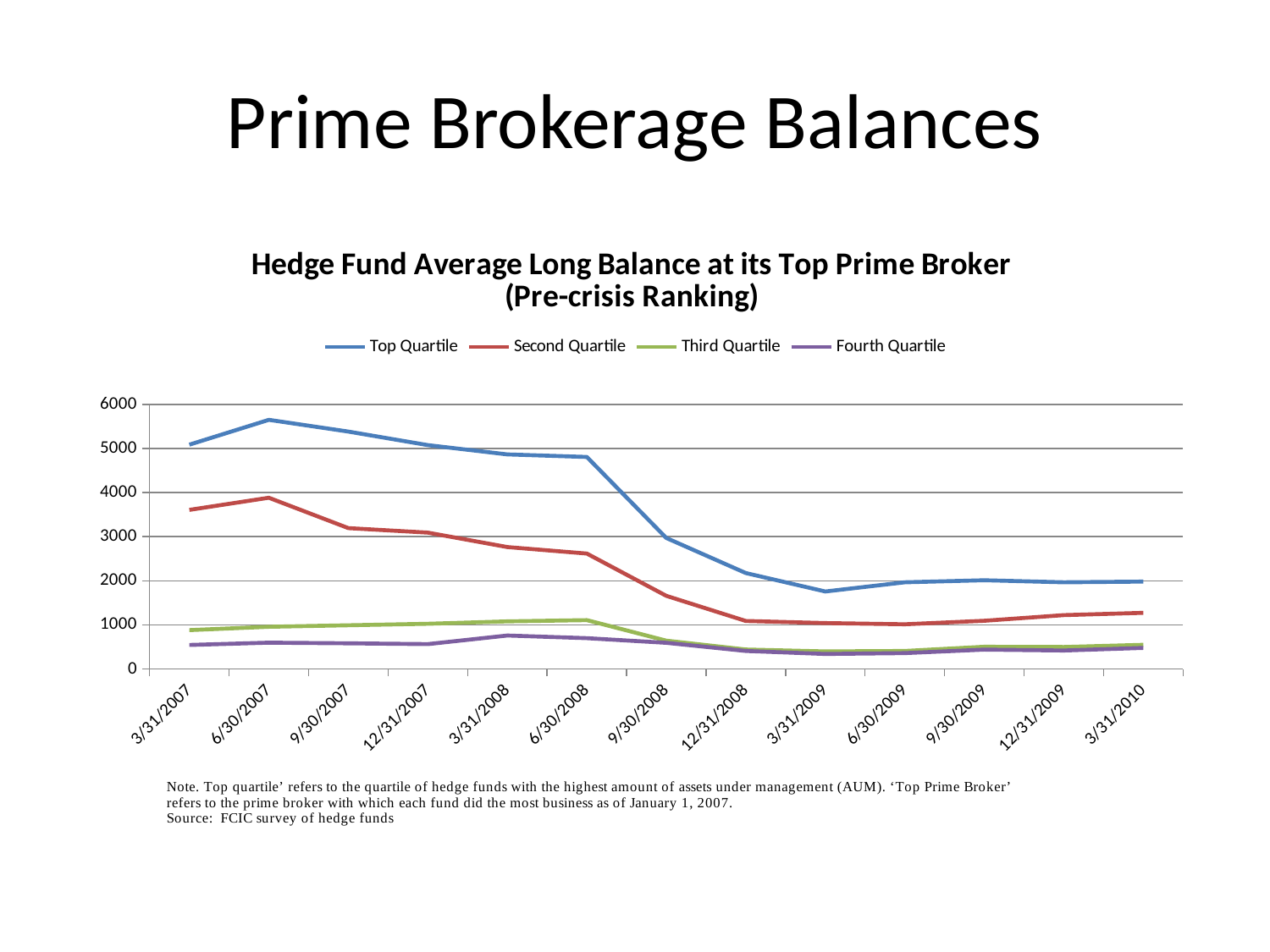
Is the Second Quartile value at 3/31/2007 greater or less than 3000? greater Does the Top Quartile line rise or fall between 6/30/2007 and 3/31/2009? fall Is the Top Quartile value at 6/30/2007 greater or less than 5000? greater Which series has the lowest value at 3/31/2007? Fourth Quartile Is the Fourth Quartile value at 3/31/2008 greater or less than 1000? less Which series has the highest value at 3/31/2007? Top Quartile Which is larger at 6/30/2008, the Top Quartile value or the Second Quartile value? Top Quartile What kind of chart is shown on the slide? line chart How many dates are shown along the x axis? 13 How many series does the legend list? 4 At which date does the Top Quartile line reach its highest value? 6/30/2007